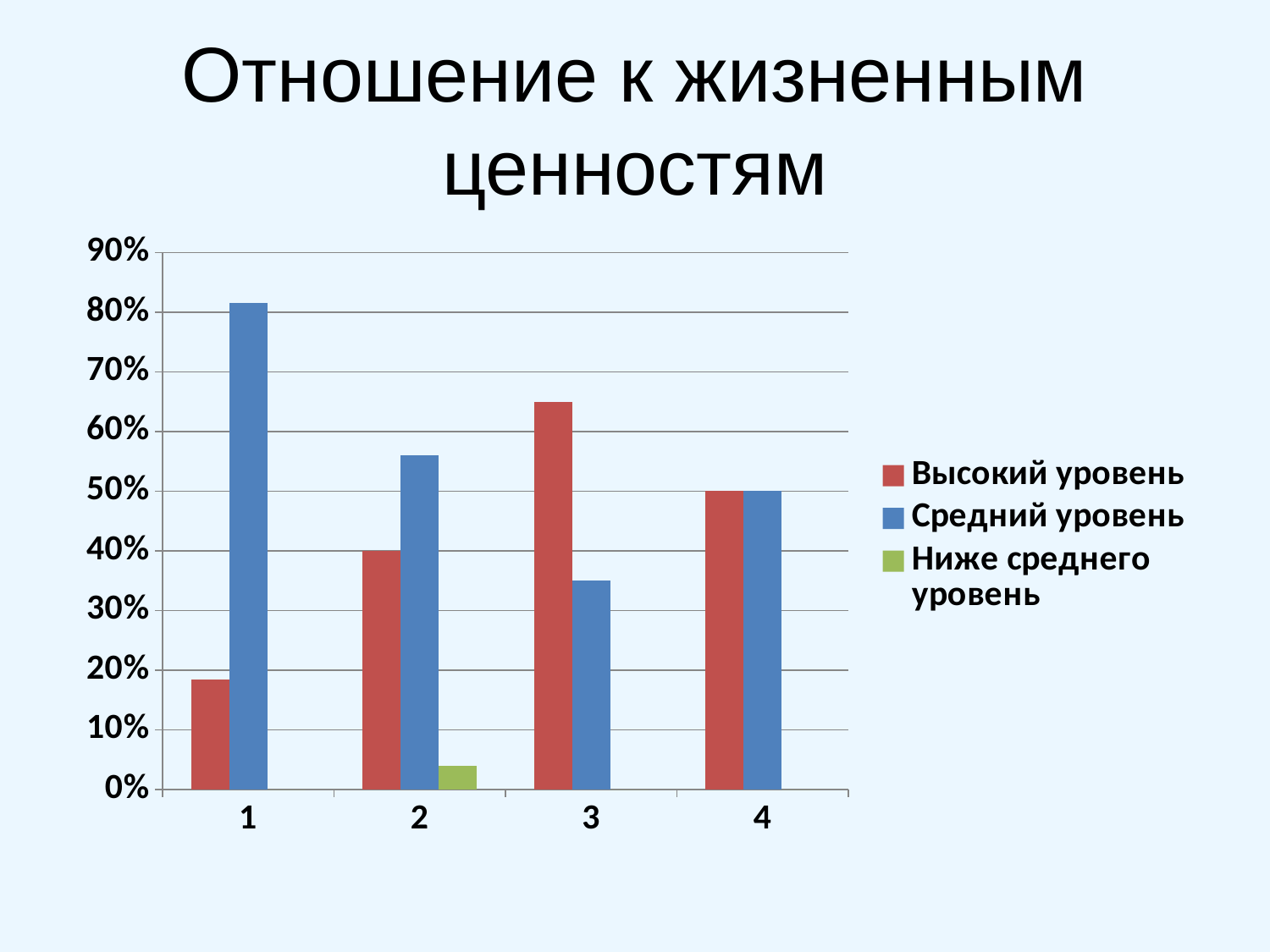
What is the title of the chart? Отношение к жизненным ценностям Which category has the highest value for Средний уровень? 1 What is the value of Высокий уровень for category 2? 40% Is the value of Ниже среднего уровень for category 2 greater or less than 10%? less How many categories are shown on the x axis? 4 How many series does the legend list? 3 Which category has the lowest value for Высокий уровень? 1 What is the value of Высокий уровень for category 4? 50% For category 2, which is larger: Высокий уровень or Средний уровень? Средний уровень Which category has the highest value for Высокий уровень? 3 What kind of chart is shown on the slide? bar chart Is the value of Средний уровень for category 1 greater or less than 70%? greater